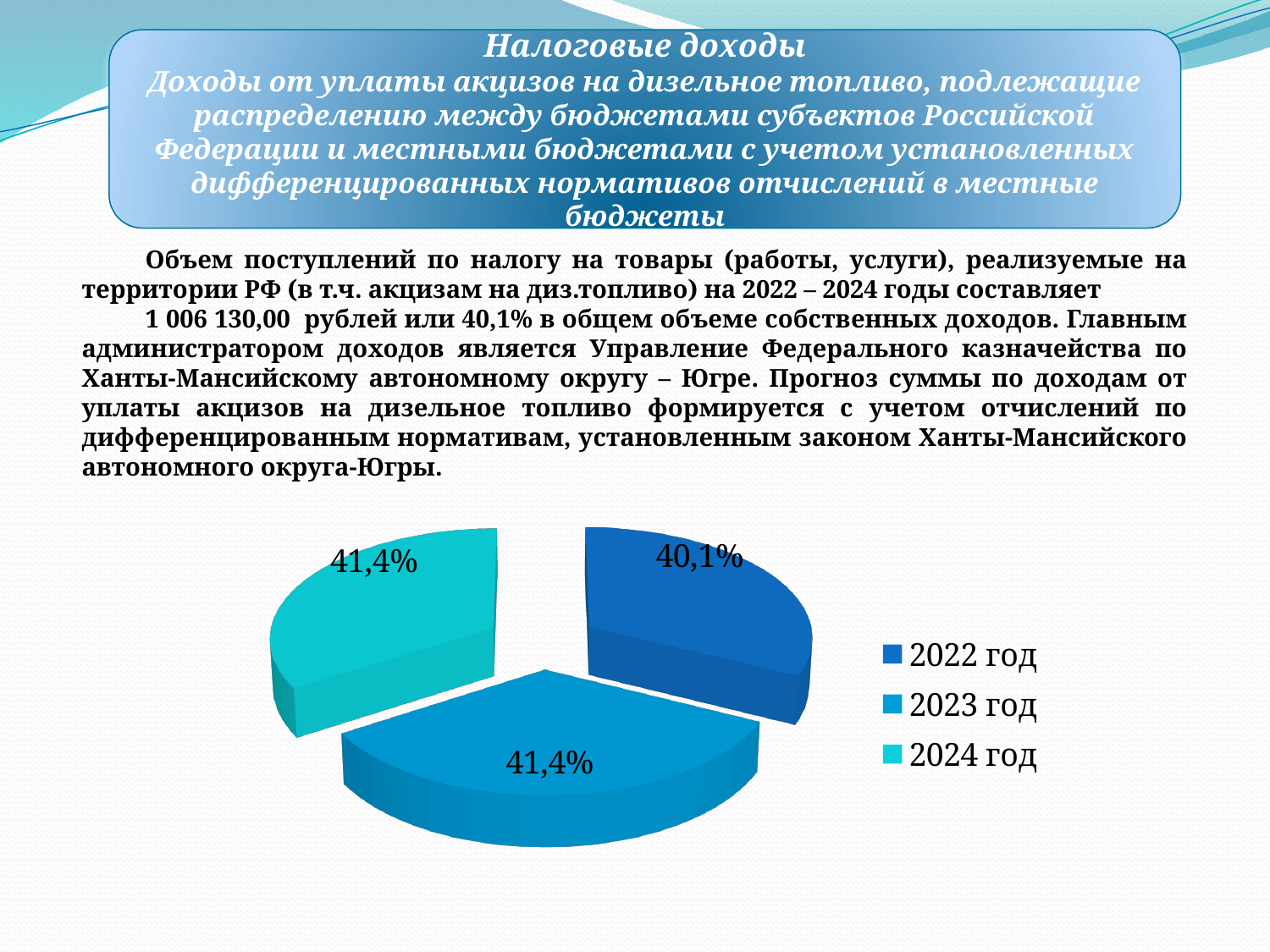
How many entries does the legend of the pie chart list? 3 Which legend entries are listed for the pie chart? 2022 год, 2023 год, 2024 год How many slices does the pie chart have? 3 What value is shown for the 2023 год slice of the pie chart? 41,4% Which is larger in the pie chart, the slice for 2022 год or the slice for 2023 год? 2023 год Is the value for 2022 год in the pie chart greater or less than 41%? less Which year is represented by the dark blue slice in the pie chart? 2022 год What type of chart is shown on the slide? Pie chart What value is shown for the 2024 год slice of the pie chart? 41,4% Which year has the smallest slice in the pie chart? 2022 год What is the difference between the values shown for 2023 год and 2022 год in the pie chart? 1,3% What value is shown for the 2022 год slice of the pie chart? 40,1%